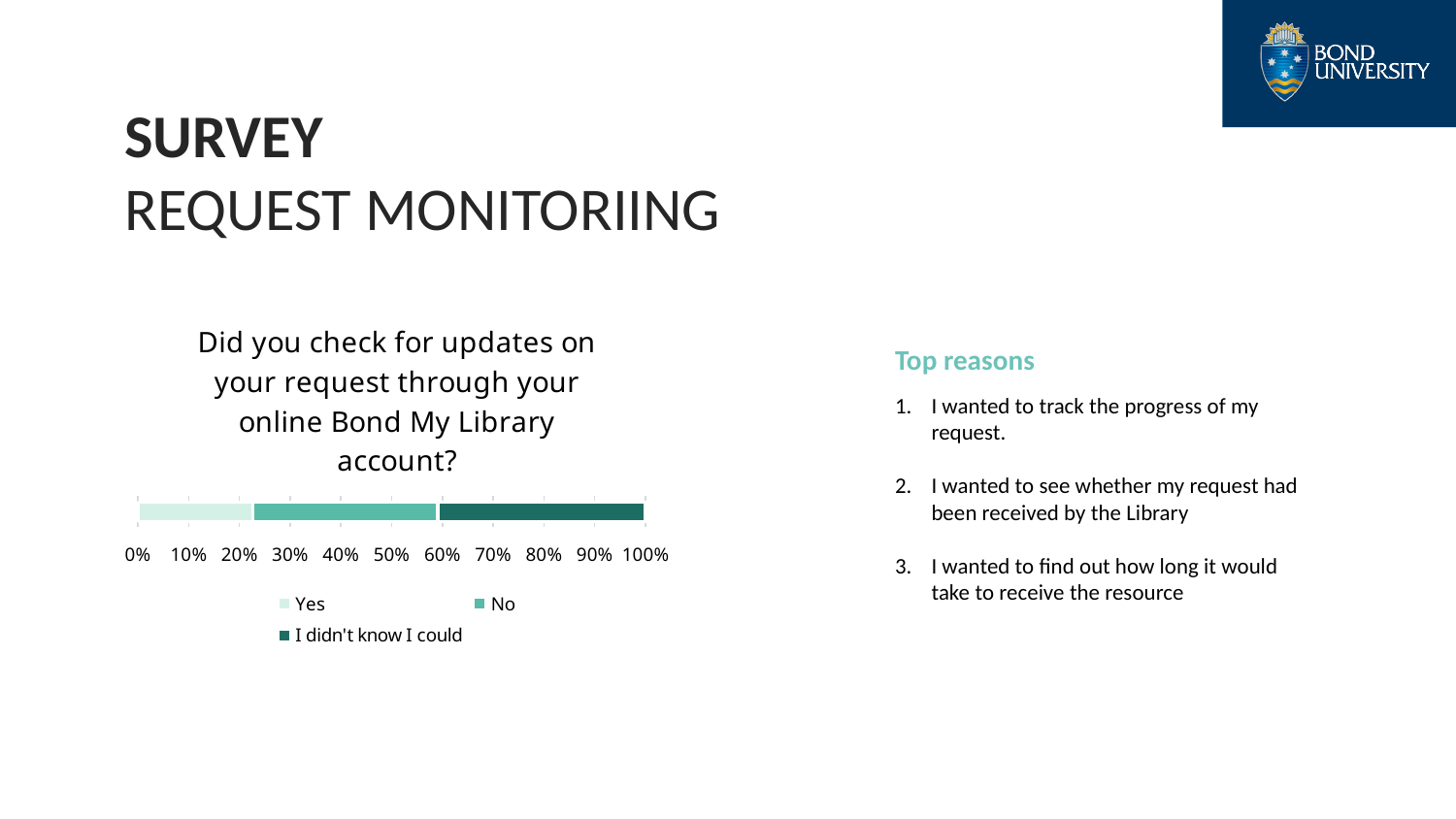
Is the share for No greater or less than 30%? greater What are the three response options listed in the chart's legend? Yes, No, I didn't know I could Is the share for Yes greater or less than 30%? less What is the highest value shown on the chart's horizontal axis? 100% What kind of chart is shown on the slide? bar chart What question is the chart titled with? Did you check for updates on your request through your online Bond My Library account? Is the share for 'I didn't know I could' greater or less than 50%? less Which is larger, the share for Yes or the share for No? No How many series does the legend of the chart list? 3 Which response option has the smallest share of the bar? Yes